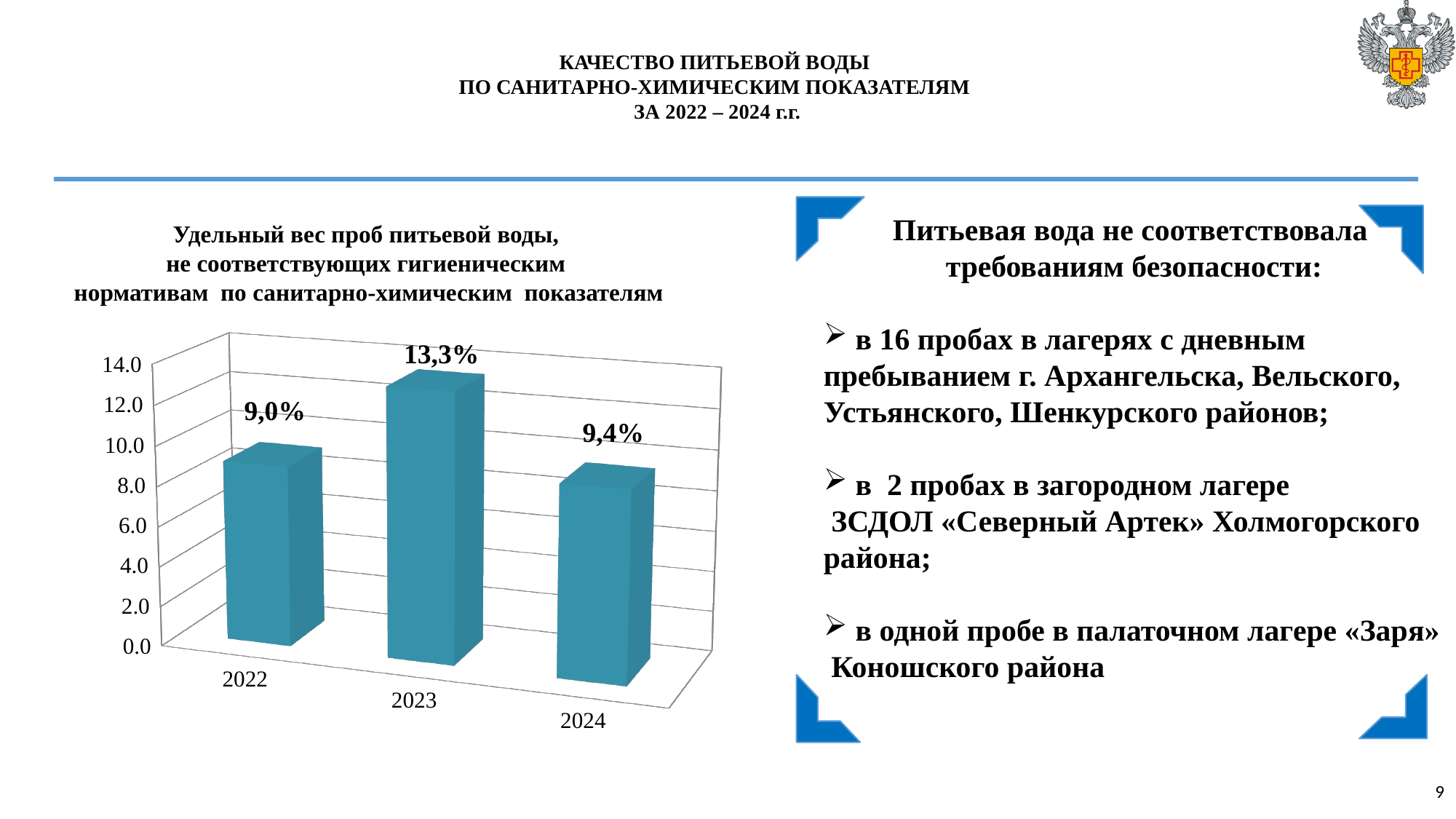
What is the value for 2024? 9,4% Is the value for 2023 greater or less than 12.0? greater What is the value for 2022? 9,0% What is the value for 2023? 13,3% What is the difference between the values for 2024 and 2022? 0,4% What kind of chart is shown on the slide? bar chart Which year has the highest value? 2023 Does the value rise or fall from 2023 to 2024? fall Which is larger, the value for 2023 or the value for 2024? 2023 How many years are shown on the chart? 3 What is the difference between the values for 2023 and 2022? 4,3% Which year has the lowest value? 2022